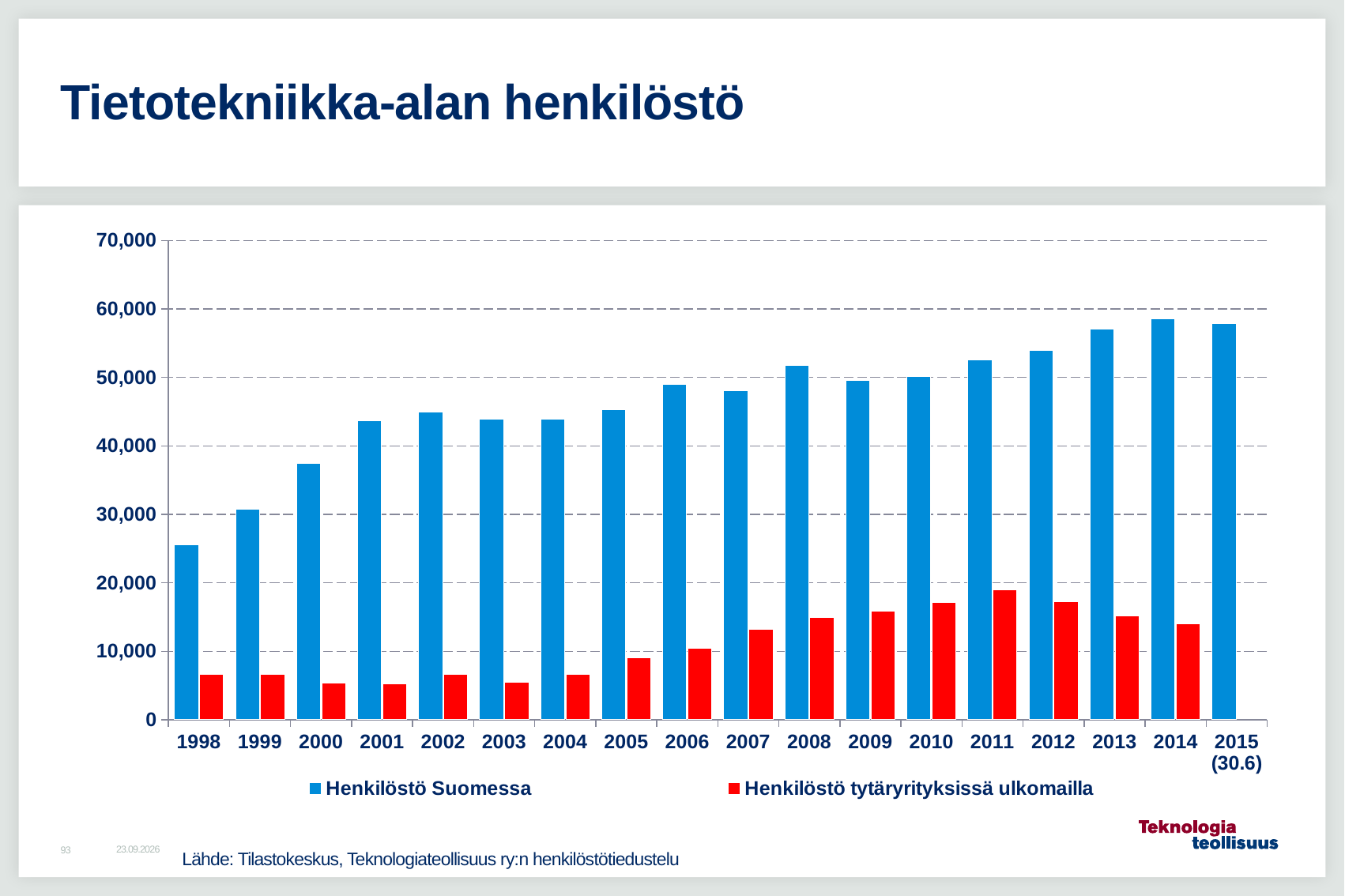
How many year categories are shown on the x axis? 18 Which year has the highest value for Henkilöstö tytäryrityksissä ulkomailla? 2011 Does the value for Henkilöstö Suomessa generally rise or fall from 1998 to 2014? rise Is the value for Henkilöstö tytäryrityksissä ulkomailla in 2011 greater or less than 10,000? greater Which year has the lowest value for Henkilöstö Suomessa? 1998 Is the value for Henkilöstö Suomessa in 2014 greater or less than 50,000? greater What type of chart is shown on the slide? bar chart Is the value for Henkilöstö Suomessa in 1998 greater or less than 30,000? less What colour are the bars for Henkilöstö tytäryrityksissä ulkomailla? red Which is larger: Henkilöstö Suomessa in 2000 or Henkilöstö Suomessa in 2010? 2010 How many series does the legend list? 2